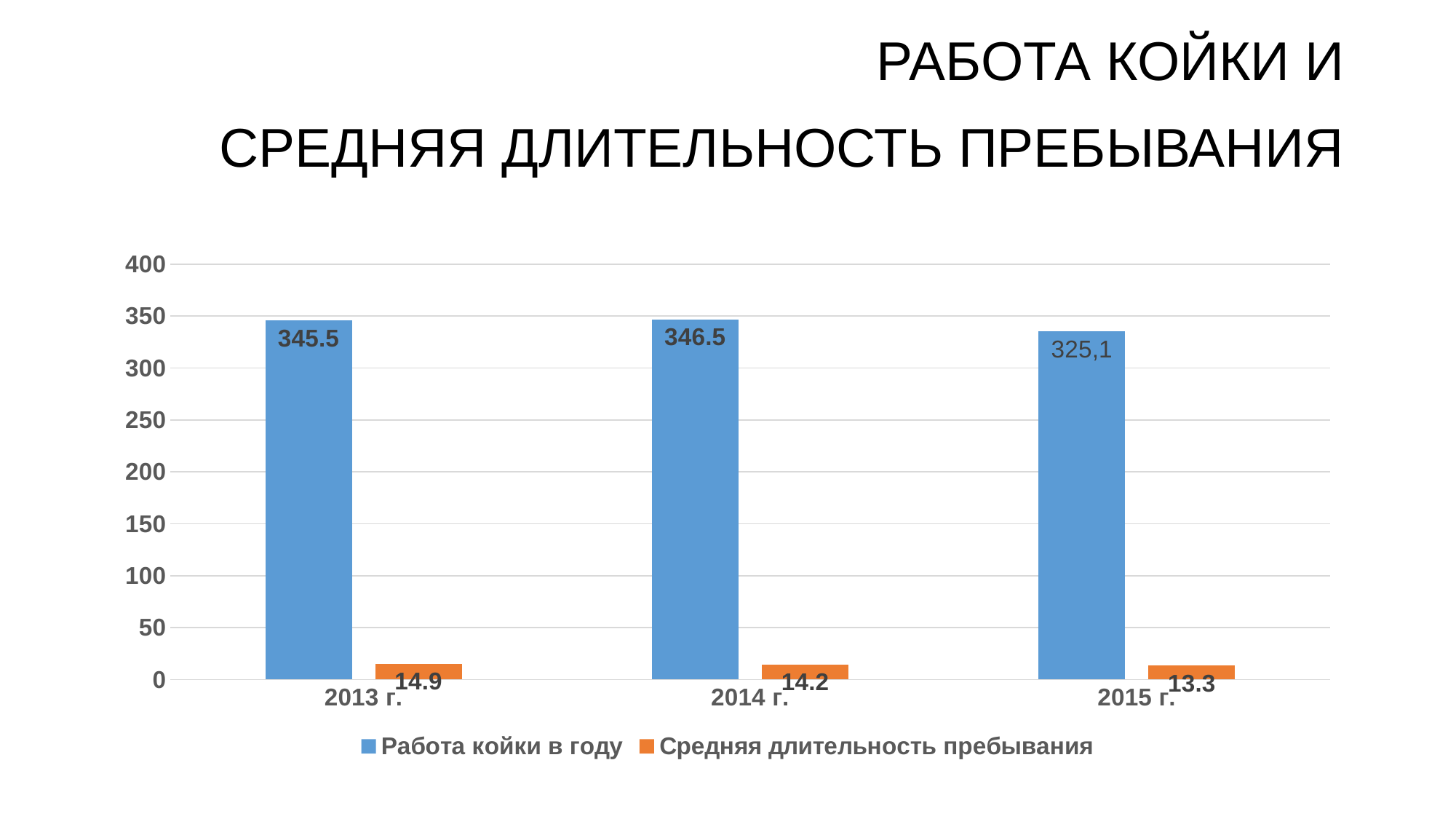
Is the value of Работа койки в году for 2015 г. greater or less than 300? greater What is the value of Средняя длительность пребывания for 2014 г.? 14.2 Does Средняя длительность пребывания rise or fall from 2013 г. to 2015 г.? fall What is the value of Работа койки в году for 2013 г.? 345.5 How many series does the legend list? 2 In which year is Средняя длительность пребывания the lowest? 2015 г. How many years are shown on the x axis? 3 What is the value of Средняя длительность пребывания for 2015 г.? 13.3 What is the difference between Средняя длительность пребывания in 2013 г. and 2014 г.? 0.7 Which is larger: Работа койки в году in 2013 г. or in 2015 г.? 2013 г. What is the value of Работа койки в году for 2015 г.? 325,1 In which year is Работа койки в году the highest? 2014 г.